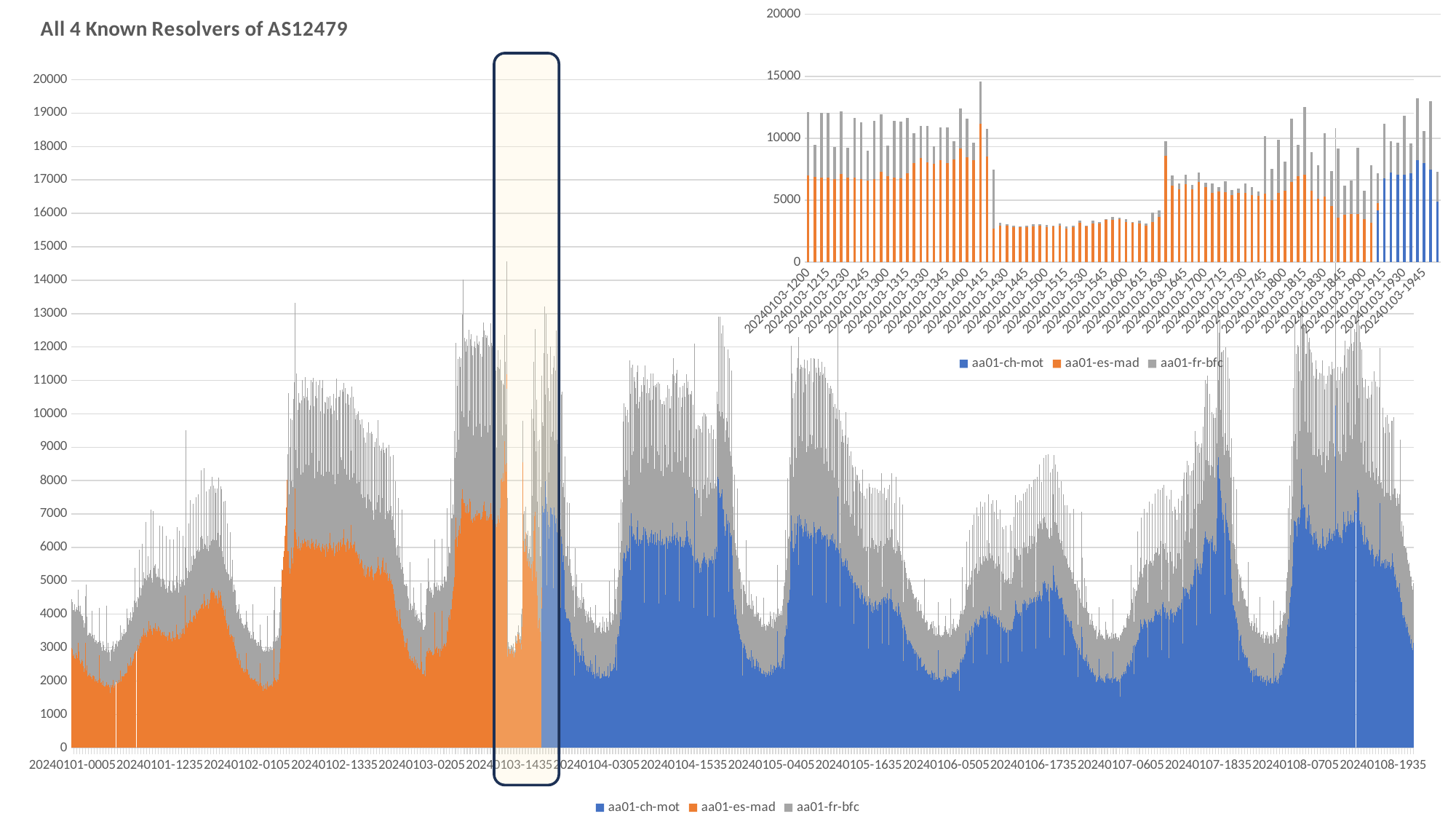
What is the last x-axis label on the main chart? 20240108-1935 What is the first x-axis label on the main chart? 20240101-0005 In the inset chart at the top right, does the aa01-es-mad series rise or fall between 20240103-1415 and 20240103-1445? fall What kind of chart is the main chart titled 'All 4 Known Resolvers of AS12479'? Stacked bar chart In the inset chart at the top right, is the stacked total at 20240103-1500 greater or less than 5000? less How many series does the legend of the main chart list? 3 What is the title of the main chart on the slide? All 4 Known Resolvers of AS12479 In the inset chart at the top right, how many x-axis labels are shown? 32 In the inset chart at the top right, is the tallest stacked bar greater or less than 10000? greater In the inset chart at the top right, what is the first x-axis label? 20240103-1200 What is the highest value shown on the y axis of the main chart? 20000 What are the series names listed in the legend of the main chart? aa01-ch-mot, aa01-es-mad, aa01-fr-bfc